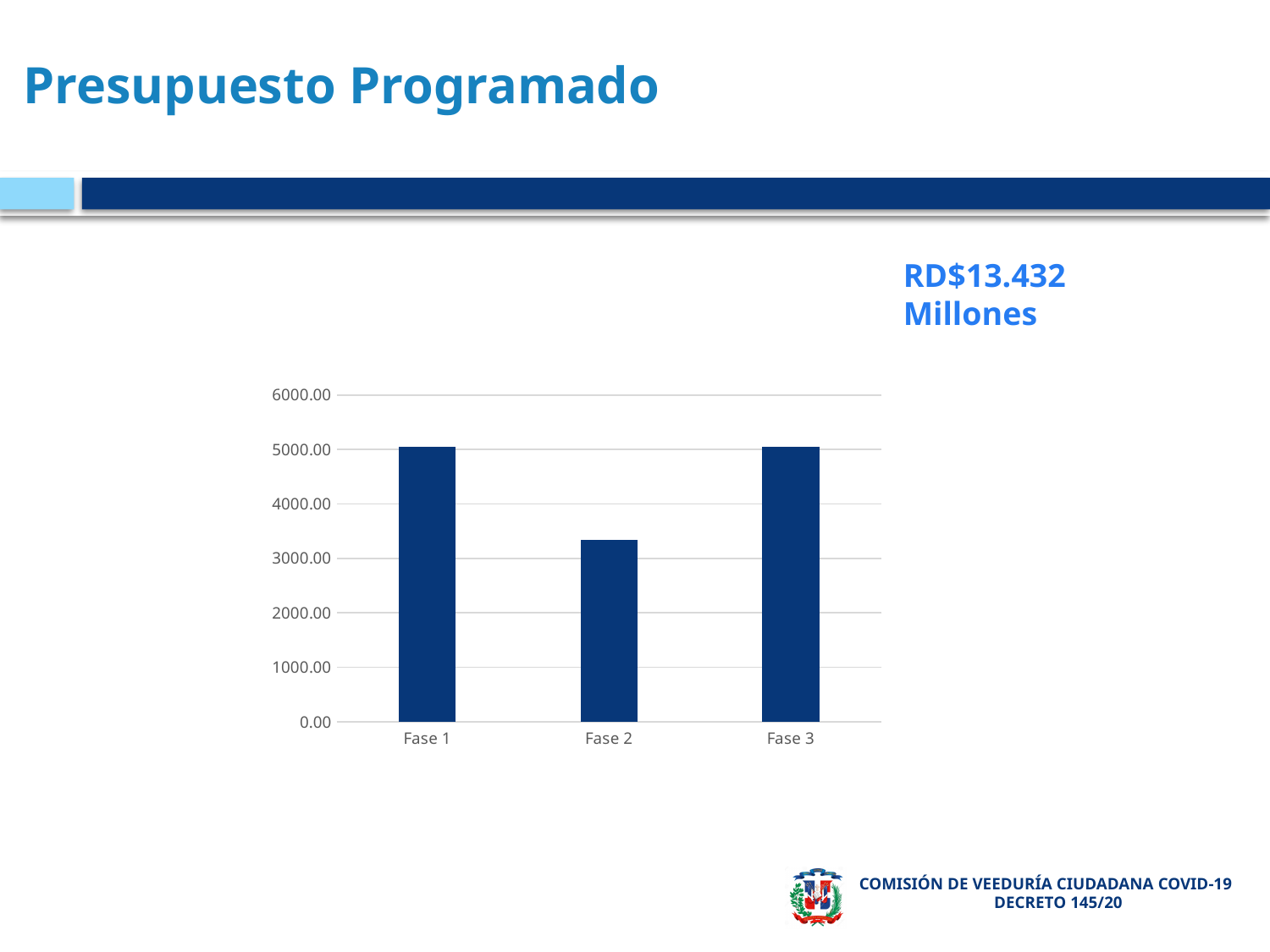
What is the title of the slide containing the chart? Presupuesto Programado Is the value for Fase 2 greater or less than 3000? greater What total amount is printed in the text next to the chart? RD$13.432 Millones Is the value for Fase 1 greater or less than 4000? greater Is the value for Fase 2 greater or less than 4000? less Which phase has the lowest value on the chart? Fase 2 Which is larger, the value for Fase 1 or the value for Fase 2? Fase 1 What kind of chart is shown on the slide? bar chart How many categories (phases) are plotted on the chart? 3 Which is larger, the value for Fase 2 or the value for Fase 3? Fase 3